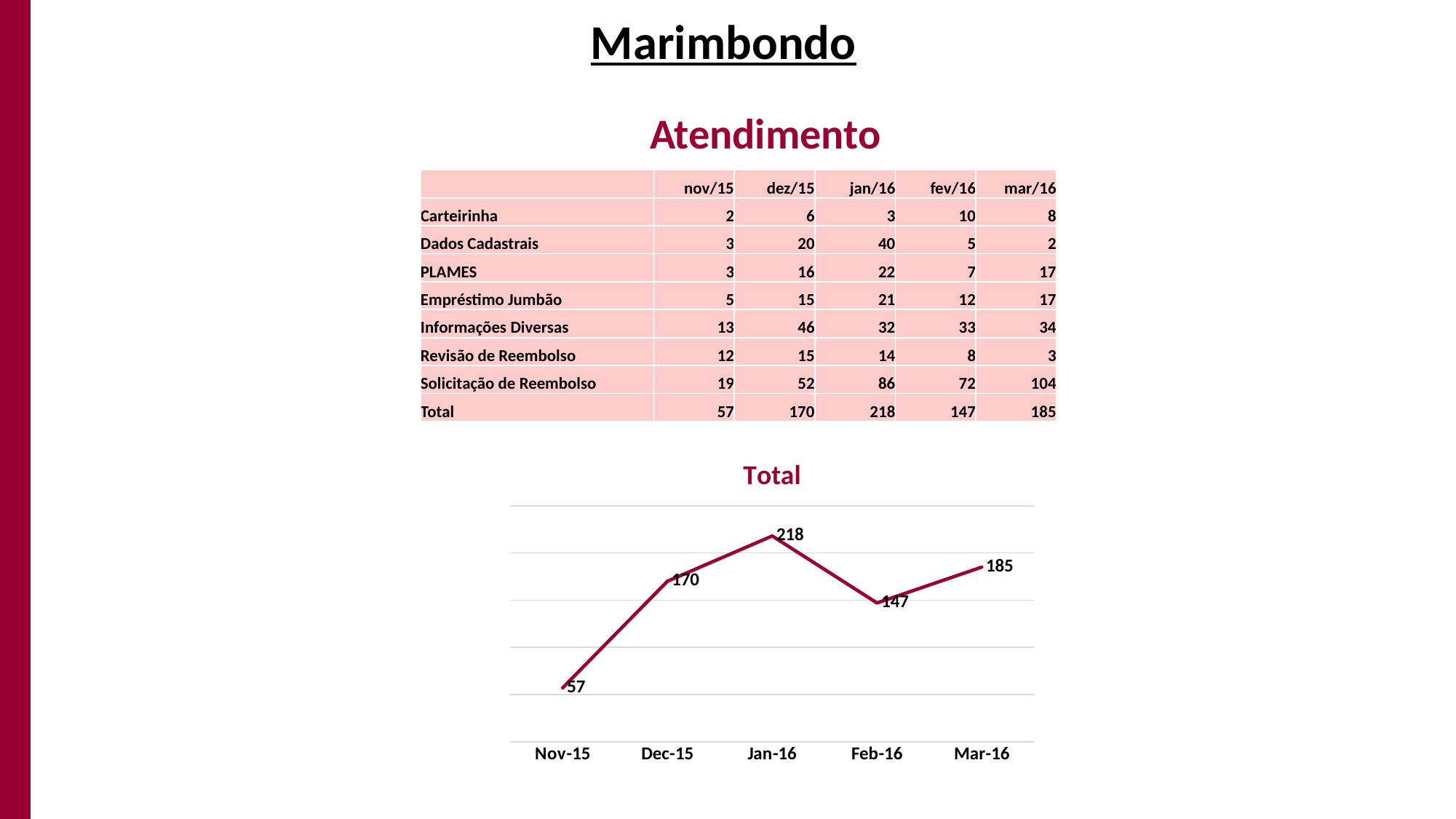
How many data points are plotted in the Total chart? 5 What is the value for Nov-15 in the Total chart? 57 Which month has the lowest value in the Total chart? Nov-15 What kind of chart is the Total chart? line chart What is the value for Mar-16 in the Total chart? 185 What is the difference between the Jan-16 and Feb-16 values in the Total chart? 71 What is the title of the chart on the slide? Total In the Total chart, does the value rise or fall from Jan-16 to Feb-16? fall In the Total chart, which is larger, the value for Dec-15 or the value for Mar-16? Mar-16 Which month has the highest value in the Total chart? Jan-16 What is the value for Jan-16 in the Total chart? 218 What is the difference between the Dec-15 and Nov-15 values in the Total chart? 113